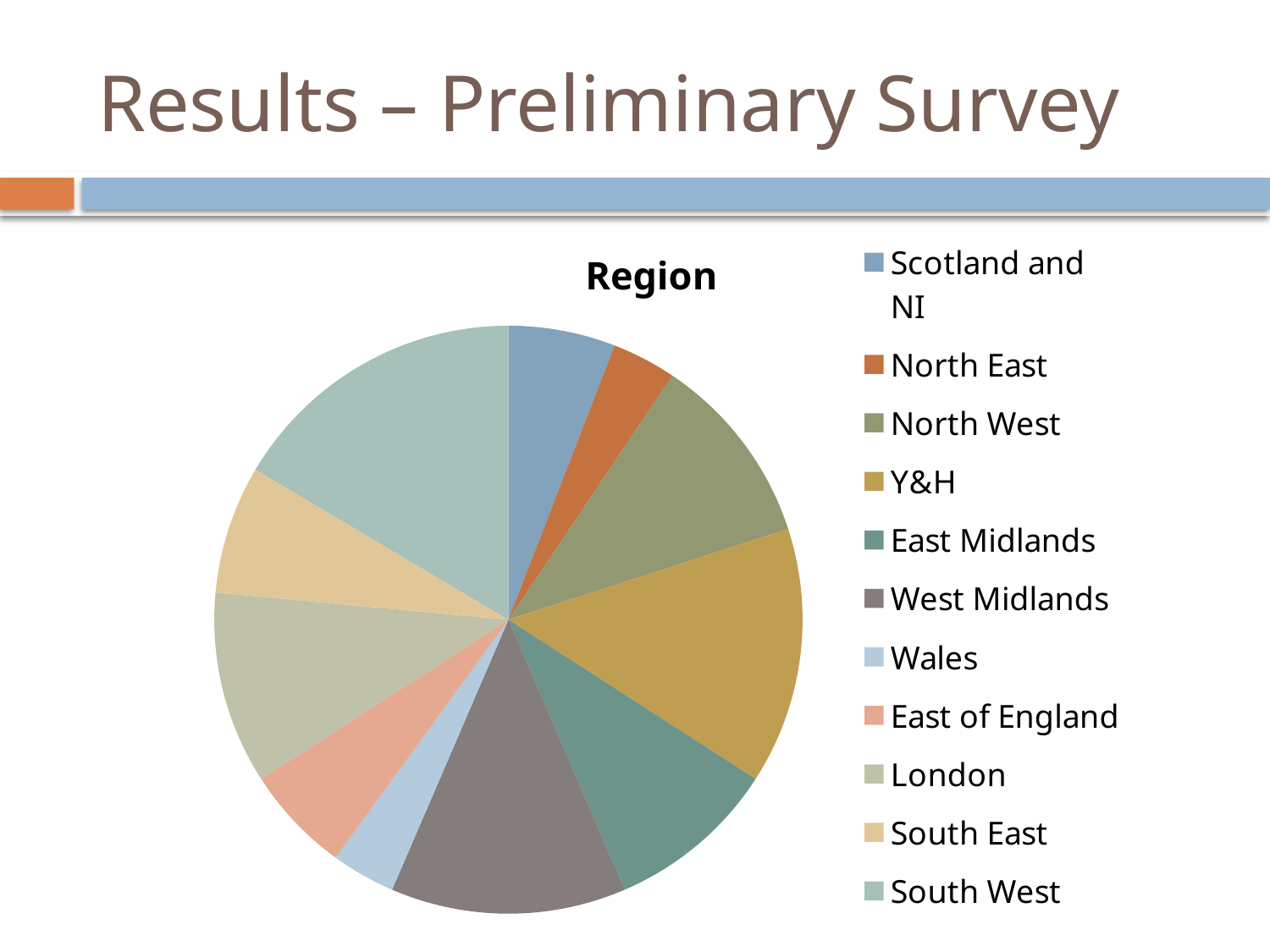
Which slice is larger, West Midlands or Scotland and NI? West Midlands Which slice is larger, South West or North East? South West What kind of chart is shown on the slide? Pie chart Which slice is larger, North West or East of England? North West Which region is listed first in the legend? Scotland and NI What is the title of the chart? Region How many entries does the legend list? 11 How many regions (slices) does the pie chart show? 11